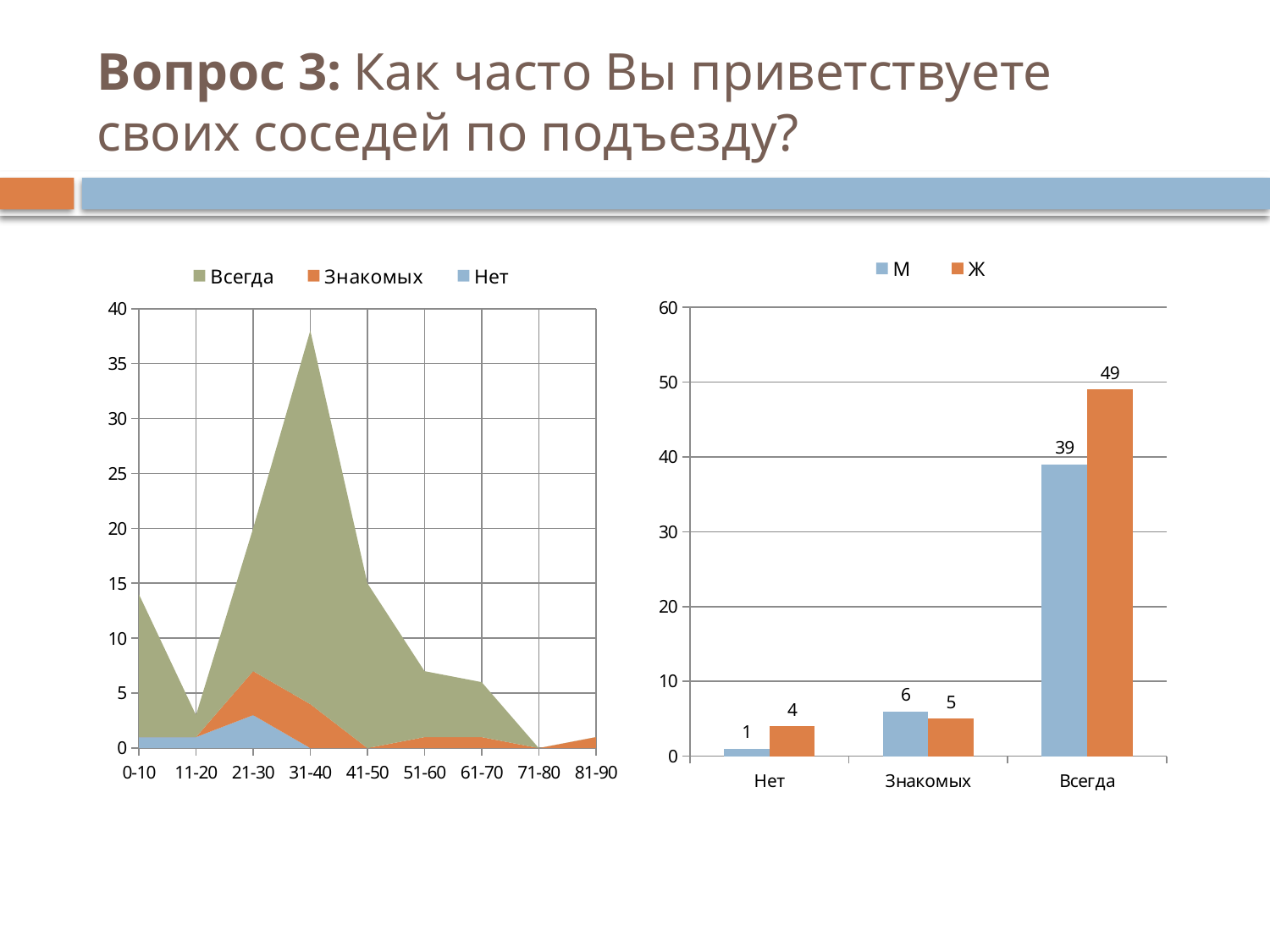
How many age groups are shown on the x axis of the left chart? 9 What kind of chart is the left chart? Stacked area chart In the right chart, what is the difference between the Ж and М values in the Всегда category? 10 In the right chart, which is larger in the Знакомых category, М or Ж? М In the right chart, which category has the lowest value for М? Нет In the right chart, which category has the highest value for Ж? Всегда In the right chart, what is the value for Ж in the Всегда category? 49 How many series does the legend of the left chart list? 3 How many categories are shown on the x axis of the right chart? 3 In the left chart, is the total stacked value for the 31-40 age group greater or less than 35? greater In the right chart, what is the value for М in the Знакомых category? 6 In the right chart, what is the value for М in the Нет category? 1